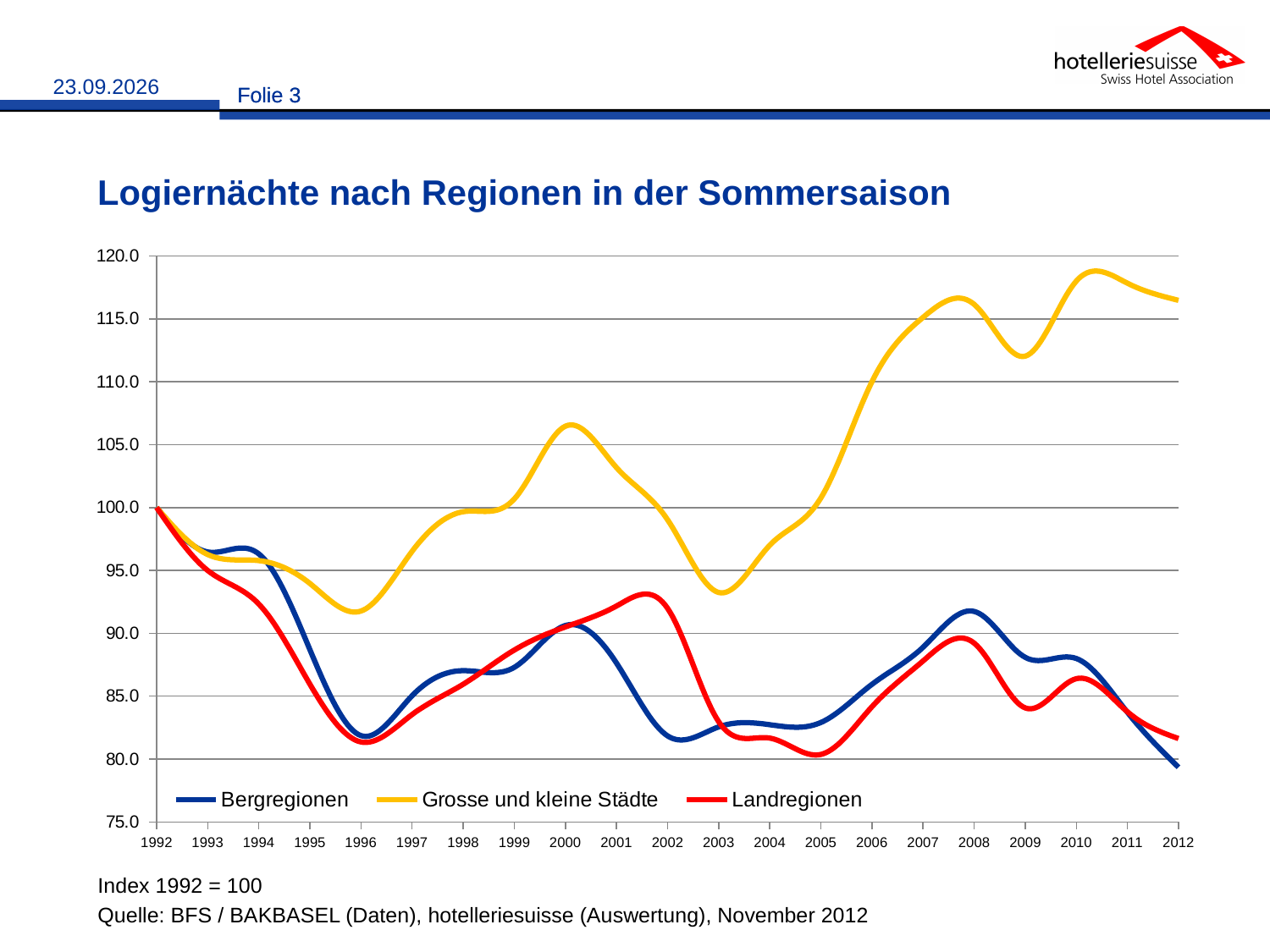
What is the value of all three series in 1992? 100.0 Is the value for Grosse und kleine Städte in 2010 greater or less than 115.0? greater What is the title of the chart? Logiernächte nach Regionen in der Sommersaison Which series has the lowest value in 2012? Bergregionen Is the value for Landregionen in 2005 greater or less than 85.0? less How many series does the legend list? 3 Does the Grosse und kleine Städte series end higher or lower in 2012 than it started in 1992? higher What kind of chart is shown on the slide? line chart How many years are shown on the x axis? 21 Is the value for Bergregionen in 2012 greater or less than 80.0? less Which series has the highest value in 2012? Grosse und kleine Städte In 2008, which is larger: the value for Bergregionen or the value for Landregionen? Bergregionen